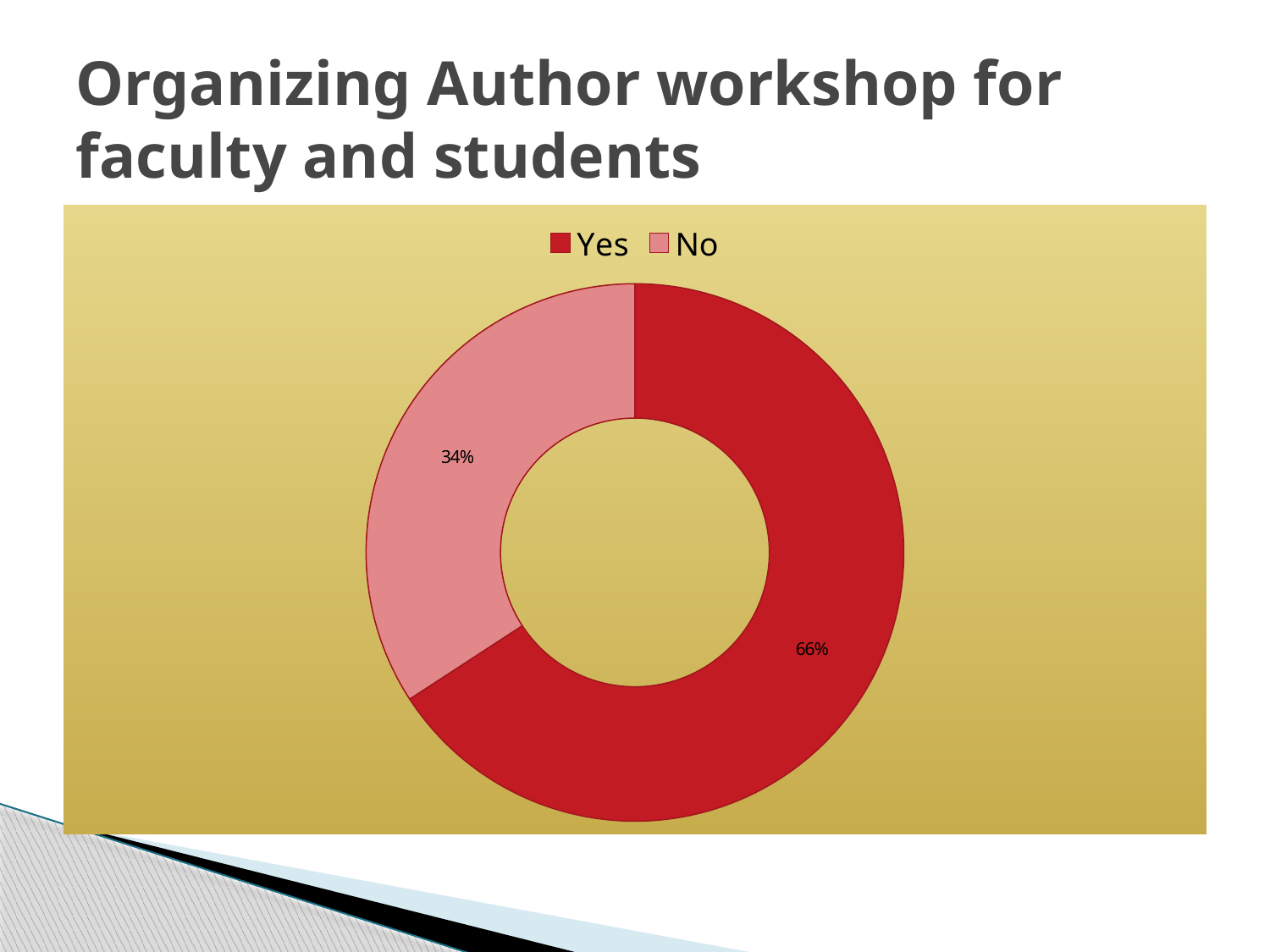
What colour is the "Yes" slice? Red Which category has the largest share of the chart? Yes Which category has the smallest share of the chart? No What are the two entries listed in the legend? Yes and No What percentage of responses are "No"? 34% What percentage of responses are "Yes"? 66% Which is larger, the "Yes" share or the "No" share? Yes How many categories does the chart show? 2 What kind of chart is shown on the slide? Doughnut (pie) chart What share of the chart does the "No" slice represent? 34% What is the total of the two percentages shown on the chart? 100% What is the difference in percentage points between the "Yes" and "No" shares? 32